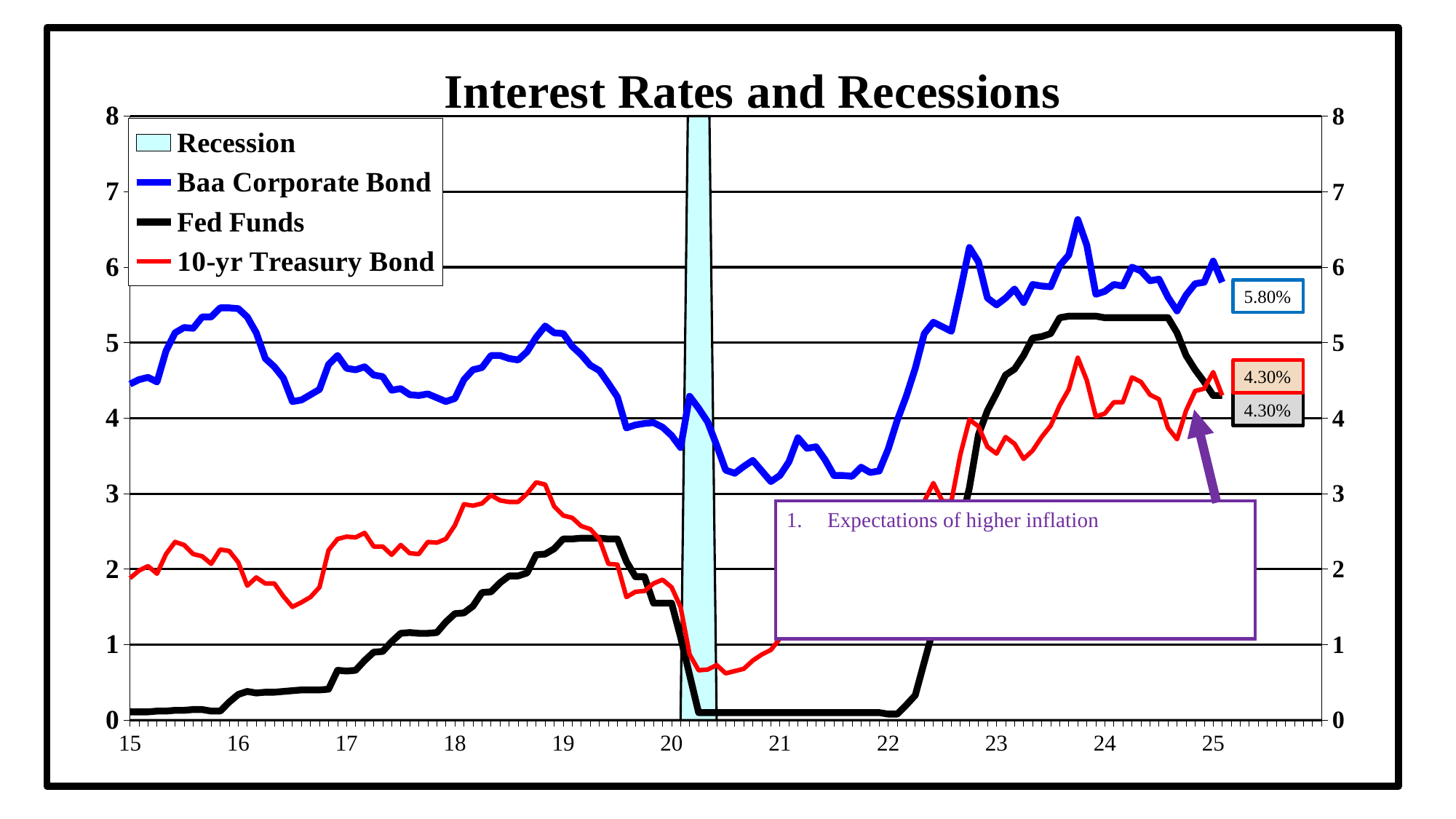
What is the difference between the latest labelled Baa Corporate Bond value and the latest labelled Fed Funds value? 1.50% What is the title of the chart? Interest Rates and Recessions Does the Fed Funds rate rise or fall between 2022 and 2023? rise What kind of chart is shown on the slide? line chart Is the Fed Funds rate during 2021 greater or less than 1? less What is the latest labelled value for the 10-yr Treasury Bond series? 4.30% Is the Baa Corporate Bond rate at the start of 2015 greater or less than 4? greater What is the latest labelled value for the Fed Funds series? 4.30% What is the latest labelled value for the Baa Corporate Bond series? 5.80% How many entries does the chart's legend list? 4 What does the light blue shaded area on the chart represent? Recession Which series reaches the highest value anywhere on the chart? Baa Corporate Bond